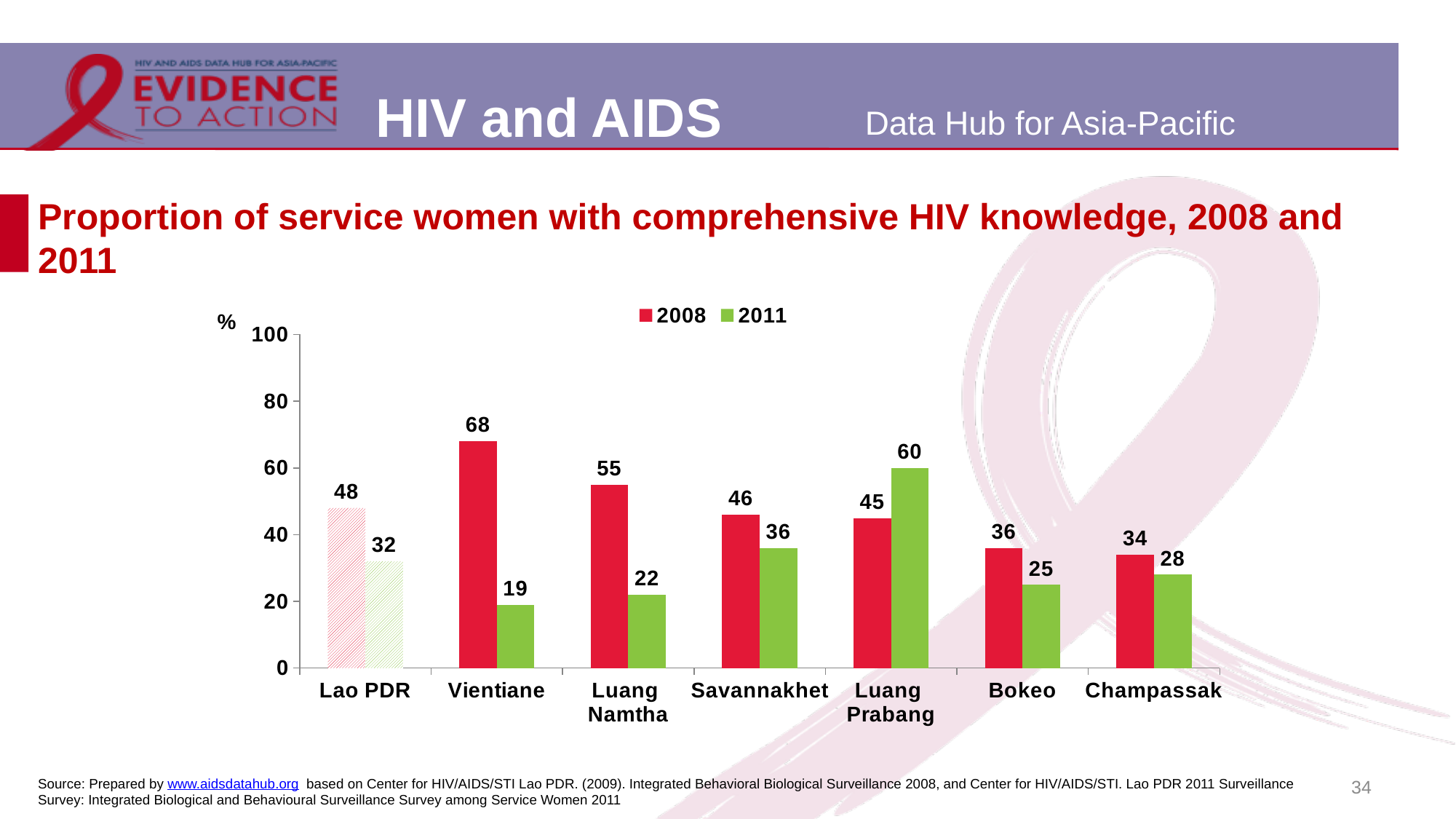
Which location had the lowest value in 2011? Vientiane What was the 2011 value for Luang Prabang? 60 How many series does the legend list? 2 Which location is the only one where the 2011 value is higher than the 2008 value? Luang Prabang What was the 2011 value for Lao PDR? 32 What was the proportion of service women with comprehensive HIV knowledge in Vientiane in 2008? 68 What kind of chart is shown on the slide? Bar chart How many locations are shown on the x axis? 7 What is the difference between the 2008 and 2011 values for Vientiane? 49 Which is larger for Luang Prabang, the 2008 value or the 2011 value? 2011 Which location had the highest value in 2008? Vientiane What colour represents the 2011 series in the legend? Green